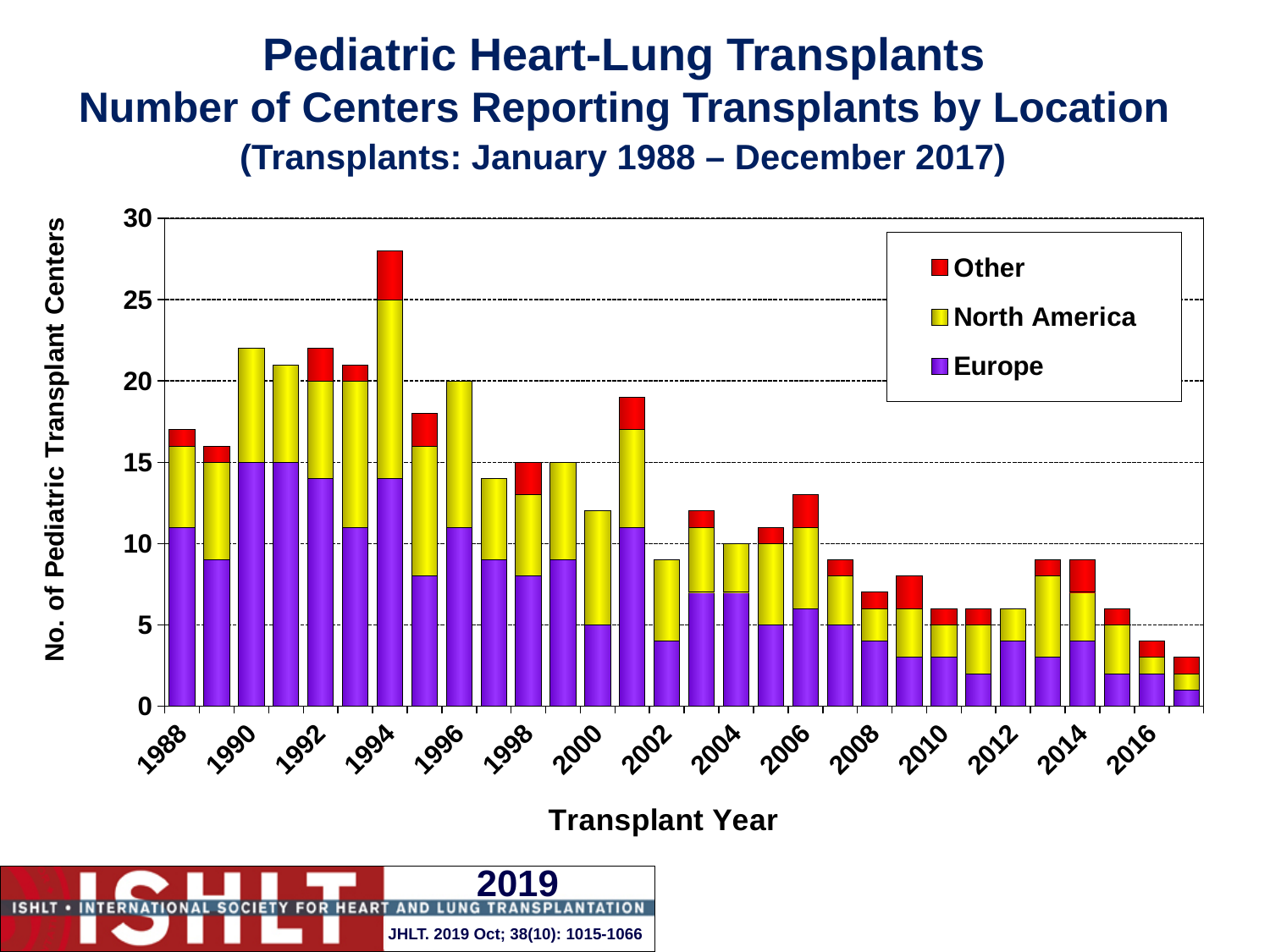
What kind of chart is shown on the slide? Stacked bar chart Which colour represents Europe in the chart? Purple Is the total number of centers for 2017 greater or less than 5? less Is the total number of centers for 1994 greater or less than 25? greater Which transplant year has the lowest total number of pediatric transplant centers? 2017 Is the total number of centers for 1990 greater or less than 20? greater Which year has a larger total number of centers, 1994 or 1996? 1994 How many series does the legend list? 3 Overall, does the total number of centers rise or fall from 1988 to 2017? Fall Which transplant year has the highest total number of pediatric transplant centers? 1994 Which year has a larger total number of centers, 2001 or 2002? 2001